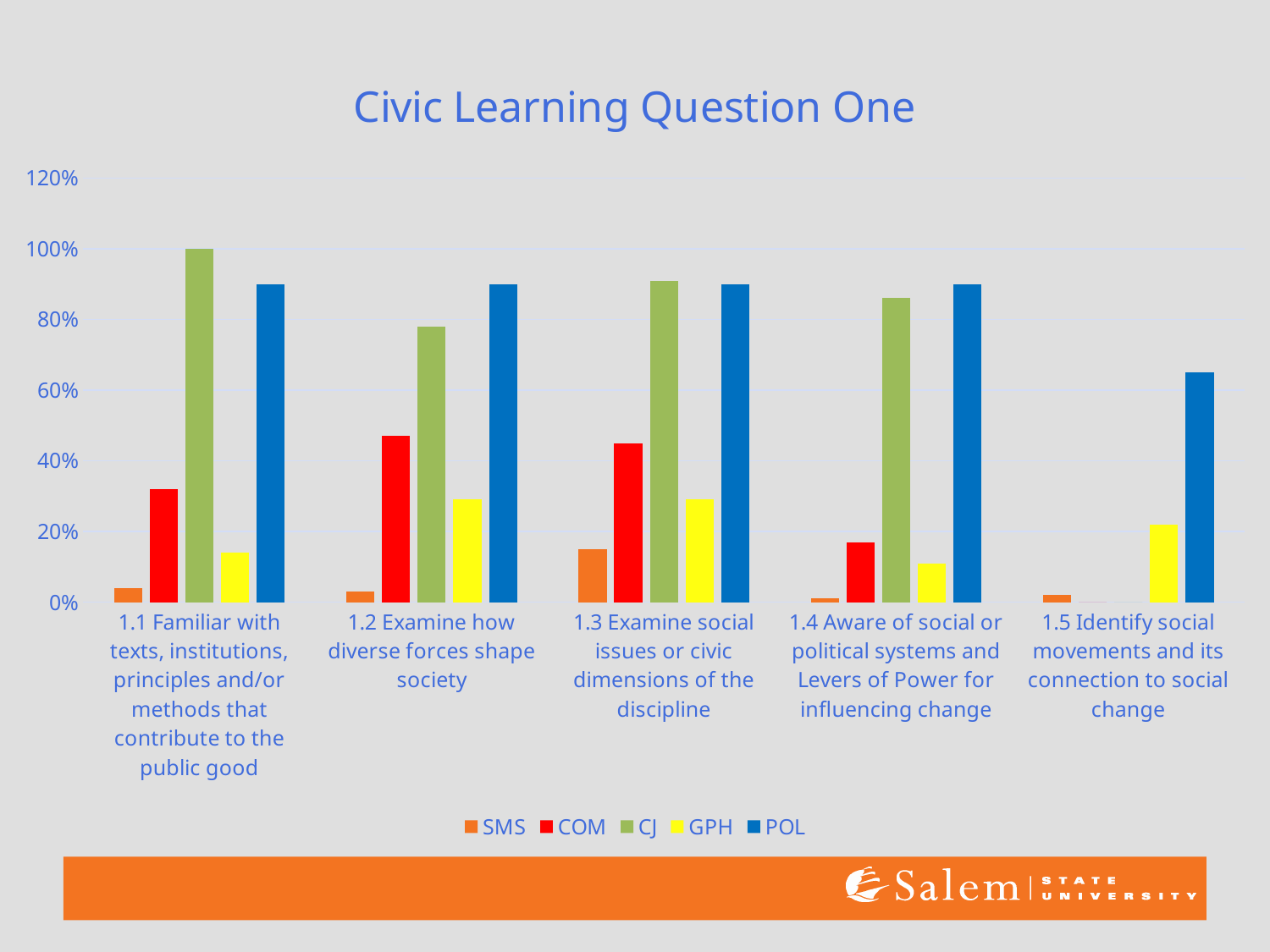
Is the value for POL in category 1.5 Identify social movements and its connection to social change greater or less than 60%? greater How many series does the legend list? 5 How many categories are shown along the x axis? 5 Is the value for CJ in category 1.4 Aware of social or political systems and Levers of Power for influencing change greater or less than 80%? greater What is the title of the chart? Civic Learning Question One Is the value for GPH in category 1.1 Familiar with texts, institutions, principles and/or methods that contribute to the public good greater or less than 20%? less Which colour represents the POL series in the legend? blue Which series has the lowest value for category 1.1 Familiar with texts, institutions, principles and/or methods that contribute to the public good? SMS Which series has the highest value for category 1.5 Identify social movements and its connection to social change? POL What type of chart is shown on the slide? bar chart For category 1.2 Examine how diverse forces shape society, which is larger: COM or GPH? COM Which series has the highest value for category 1.1 Familiar with texts, institutions, principles and/or methods that contribute to the public good? CJ